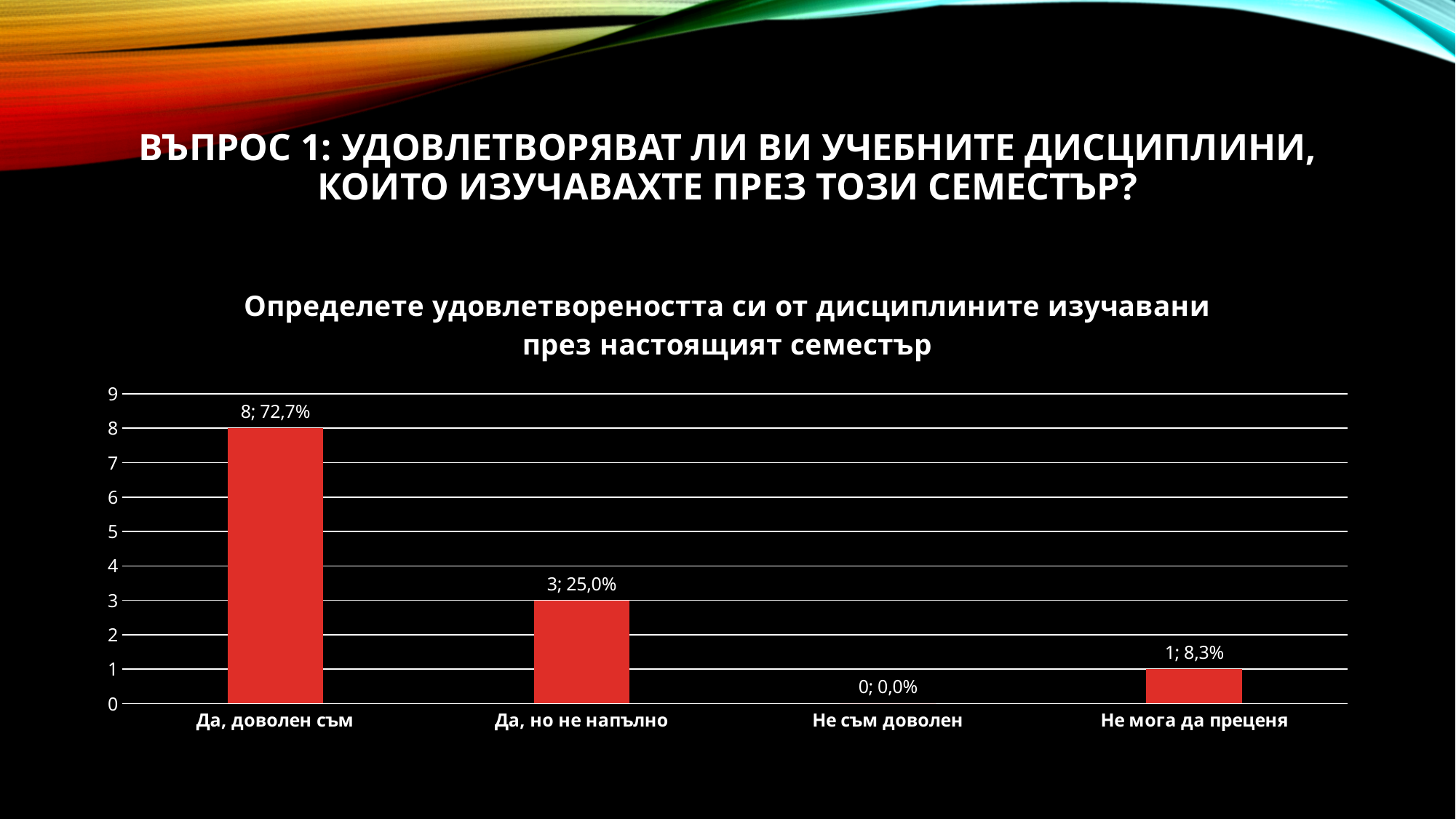
Which category has the lowest value? Не съм доволен What is the title of the chart? Определете удовлетвореността си от дисциплините изучавани през настоящият семестър Which category has the highest value? Да, доволен съм How many categories are shown on the x axis of the chart? 4 What is the full data label shown above the bar for "Не мога да преценя"? 1; 8,3% What kind of chart is shown on the slide? Bar chart What is the difference between the count for "Да, доволен съм" and the count for "Да, но не напълно"? 5 What value is shown for the category "Не съм доволен"? 0 Which is larger: the value for "Да, но не напълно" or the value for "Не мога да преценя"? Да, но не напълно What is the count value shown for the category "Да, доволен съм"? 8 What is the highest value shown on the vertical axis of the chart? 9 What percentage is shown in the data label for "Да, но не напълно"? 25,0%